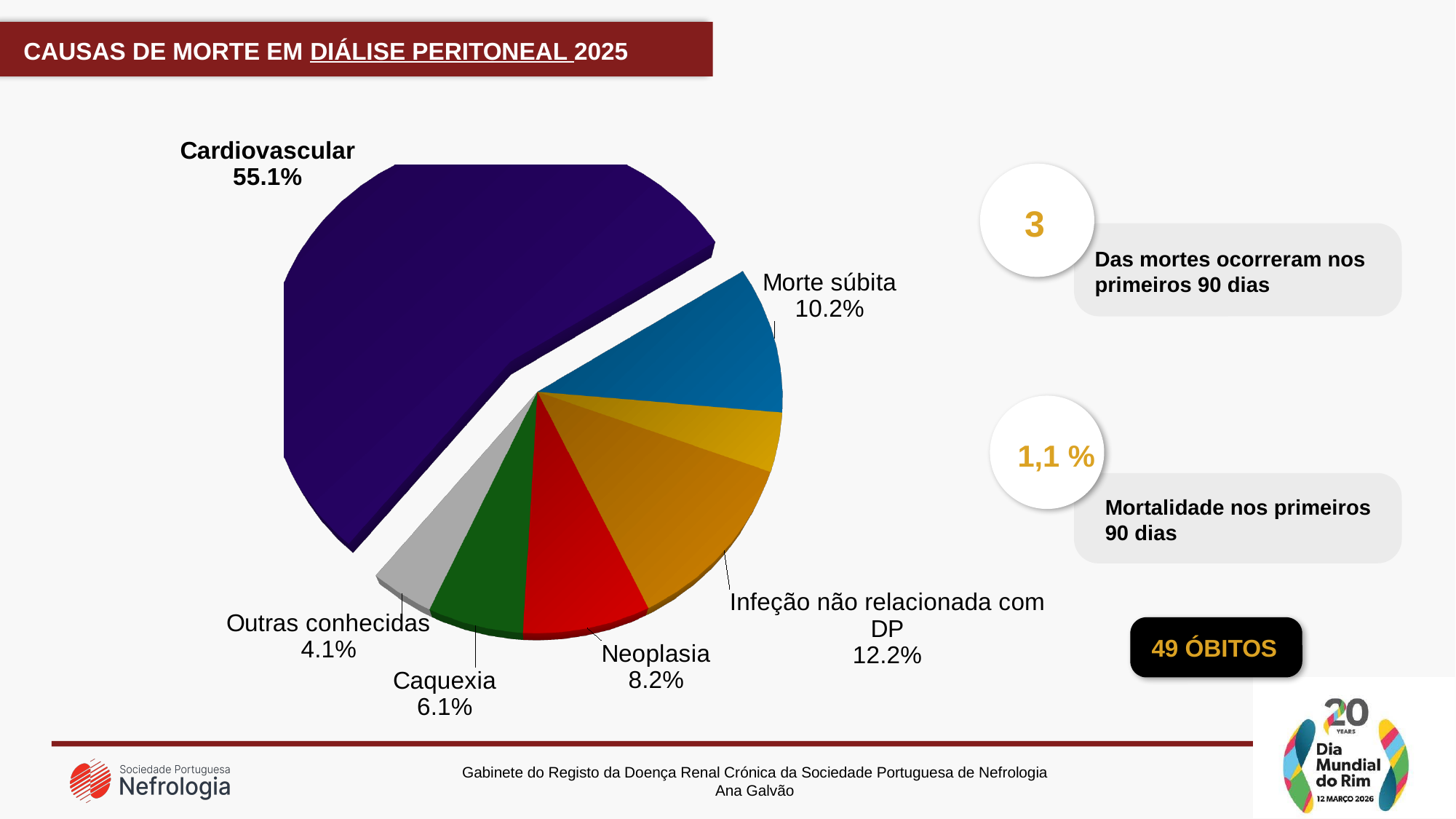
What is the share of the Morte súbita slice in the pie chart? 10.2% Which slice is larger, Caquexia or Outras conhecidas? Caquexia What is the title of the slide containing the chart? CAUSAS DE MORTE EM DIÁLISE PERITONEAL 2025 What kind of chart is shown on the slide? Pie chart Which cause of death has the largest slice in the pie chart? Cardiovascular Which slice is larger, Morte súbita or Neoplasia? Morte súbita What percentage does the Infeção não relacionada com DP slice represent? 12.2% What is the difference in percentage points between the Cardiovascular slice and the Infeção não relacionada com DP slice? 42.9 What percentage of deaths is attributed to Cardiovascular causes in the pie chart? 55.1% What is the value labelled for Outras conhecidas? 4.1% What percentage is shown for Caquexia? 6.1% What is the value shown for Neoplasia in the pie chart? 8.2%